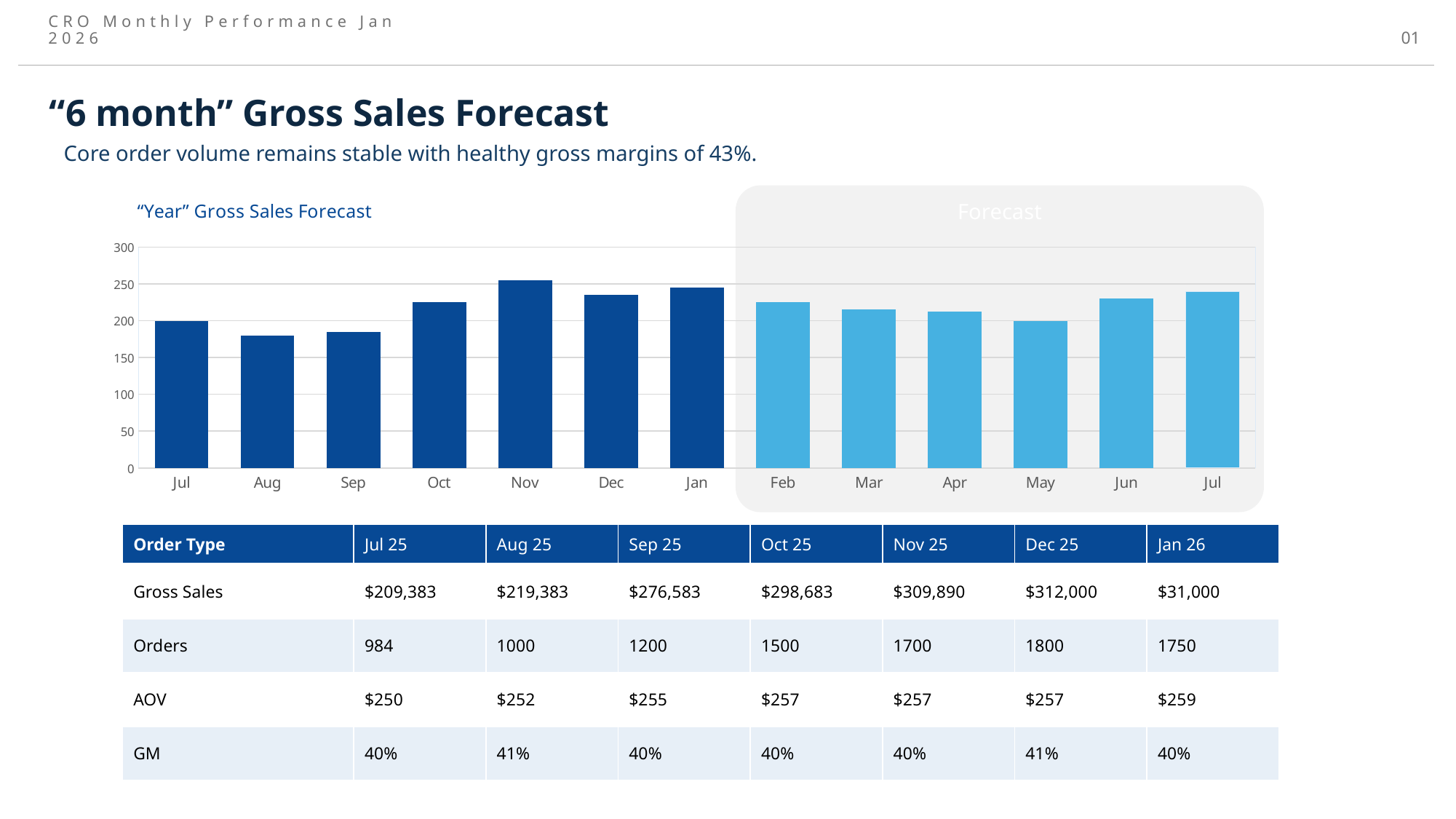
What kind of chart is shown on the slide? bar chart Is the value for Oct greater or less than 200? greater Is the value for Aug greater or less than 200? less Is the value for Dec greater or less than 250? less Which month has the highest bar in the chart? Nov What label is shown above the shaded region covering the lighter blue bars from Feb to Jul? Forecast How many months (bars) are plotted in the chart? 13 Which is larger, the value for Nov or the value for Dec? Nov What is the title of the chart? "Year" Gross Sales Forecast Which is larger, the value for Jun or the value for Mar? Jun